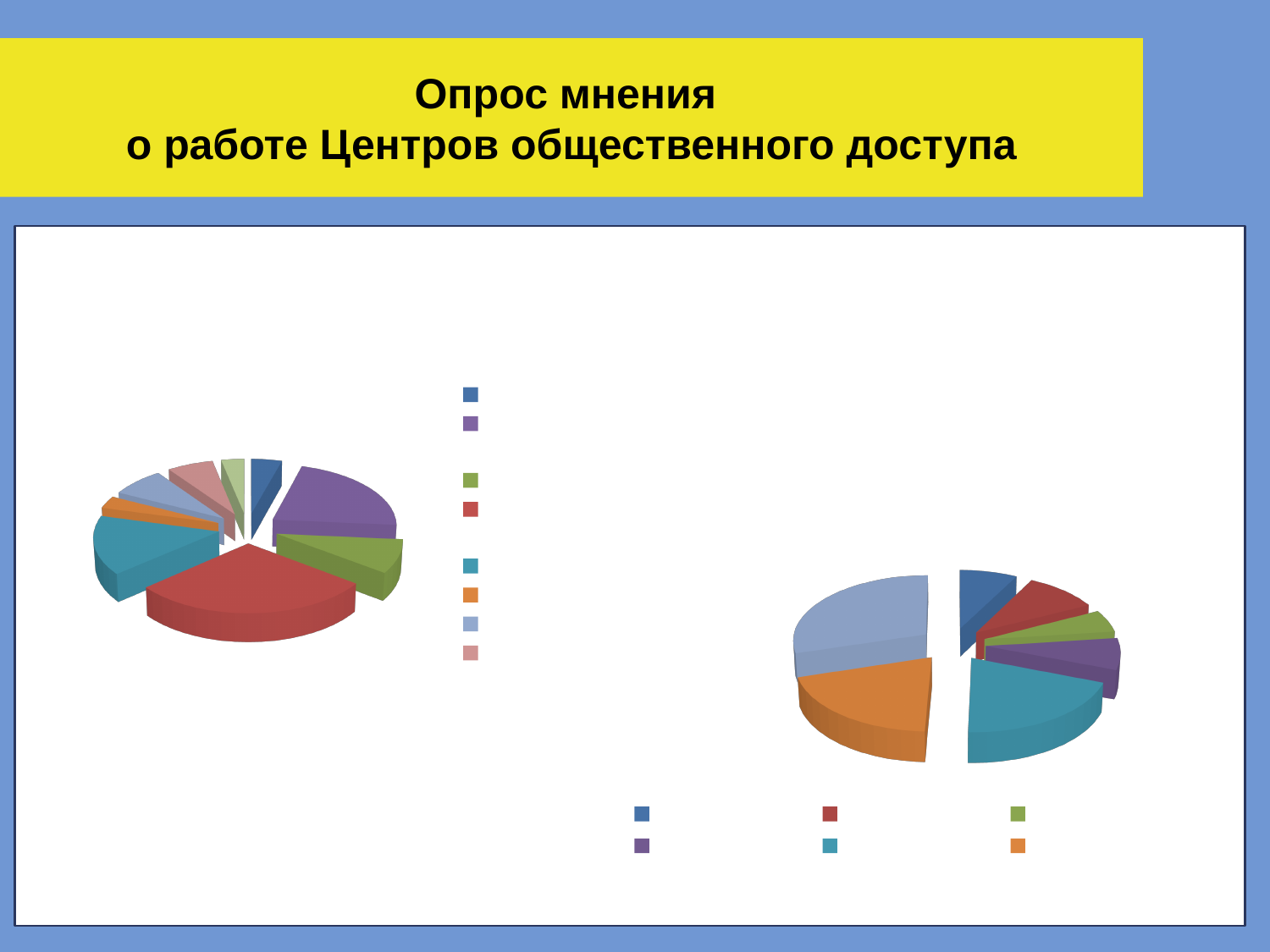
In the chart on the right, which is larger, the light blue slice or the dark blue slice? light blue How many charts are shown on the slide? 2 In the chart on the right, which is larger, the teal slice or the green slice? teal In the chart on the left, which colour slice is the largest? red What kind of chart is the chart on the right of the slide? pie chart What kind of chart is the chart on the left of the slide? pie chart What is the title of the slide? Опрос мнения о работе Центров общественного доступа In the chart on the right, which is larger, the orange slice or the red slice? orange